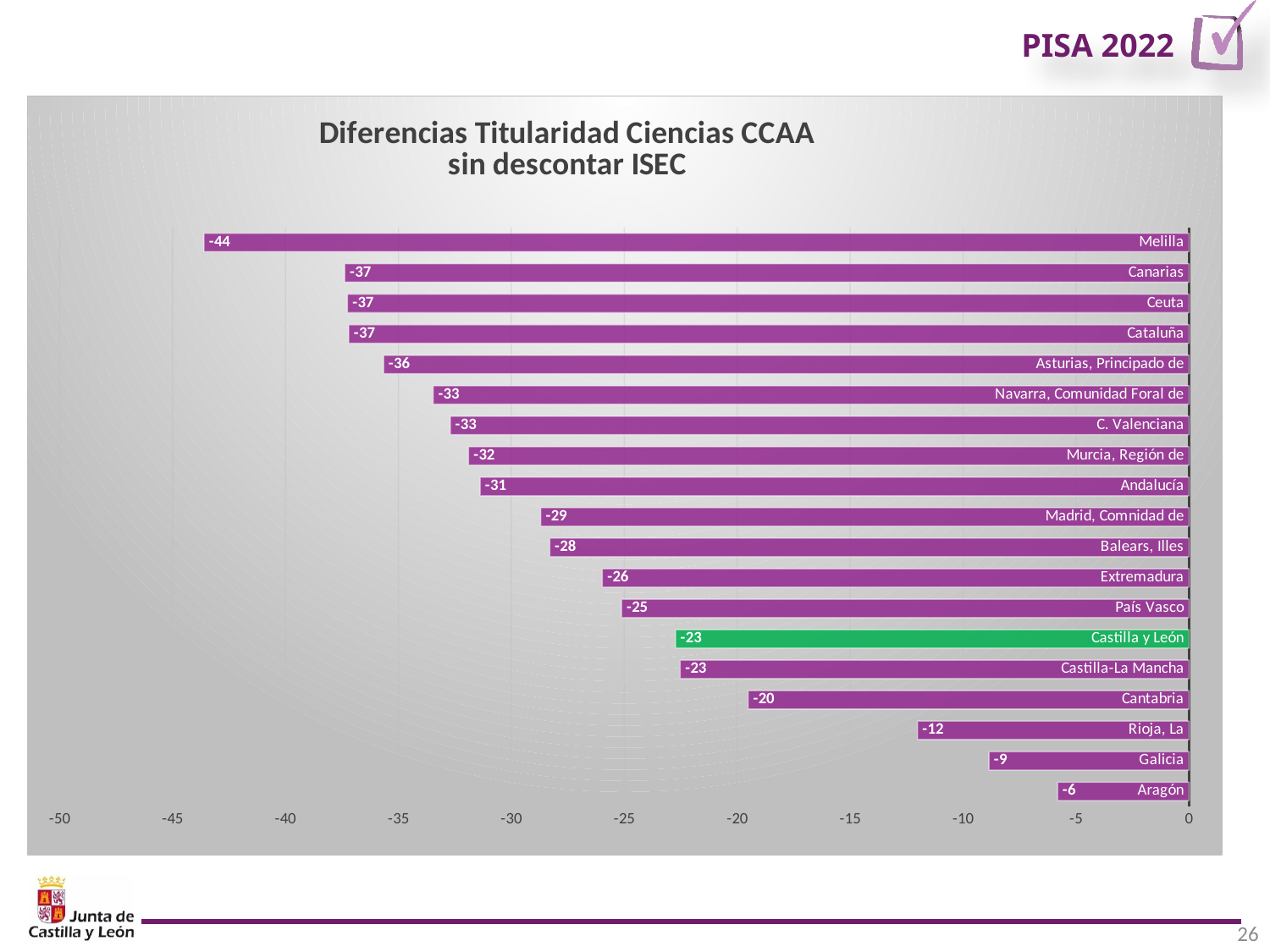
How many regions are shown on the chart? 19 Which region has the highest value (closest to zero) on the chart? Aragón What is the value shown for Cantabria? -20 Which bar is highlighted in green instead of purple? Castilla y León What is the value shown for Galicia? -9 What is the difference between the values for Melilla and Aragón? 38 What is the value shown for Melilla? -44 What type of chart is shown on the slide? Bar chart Which has a more negative value, País Vasco or Extremadura? Extremadura What is the value shown for Castilla y León? -23 Which region has the lowest (most negative) value on the chart? Melilla What is the difference between the values for Castilla y León and Cantabria? 3